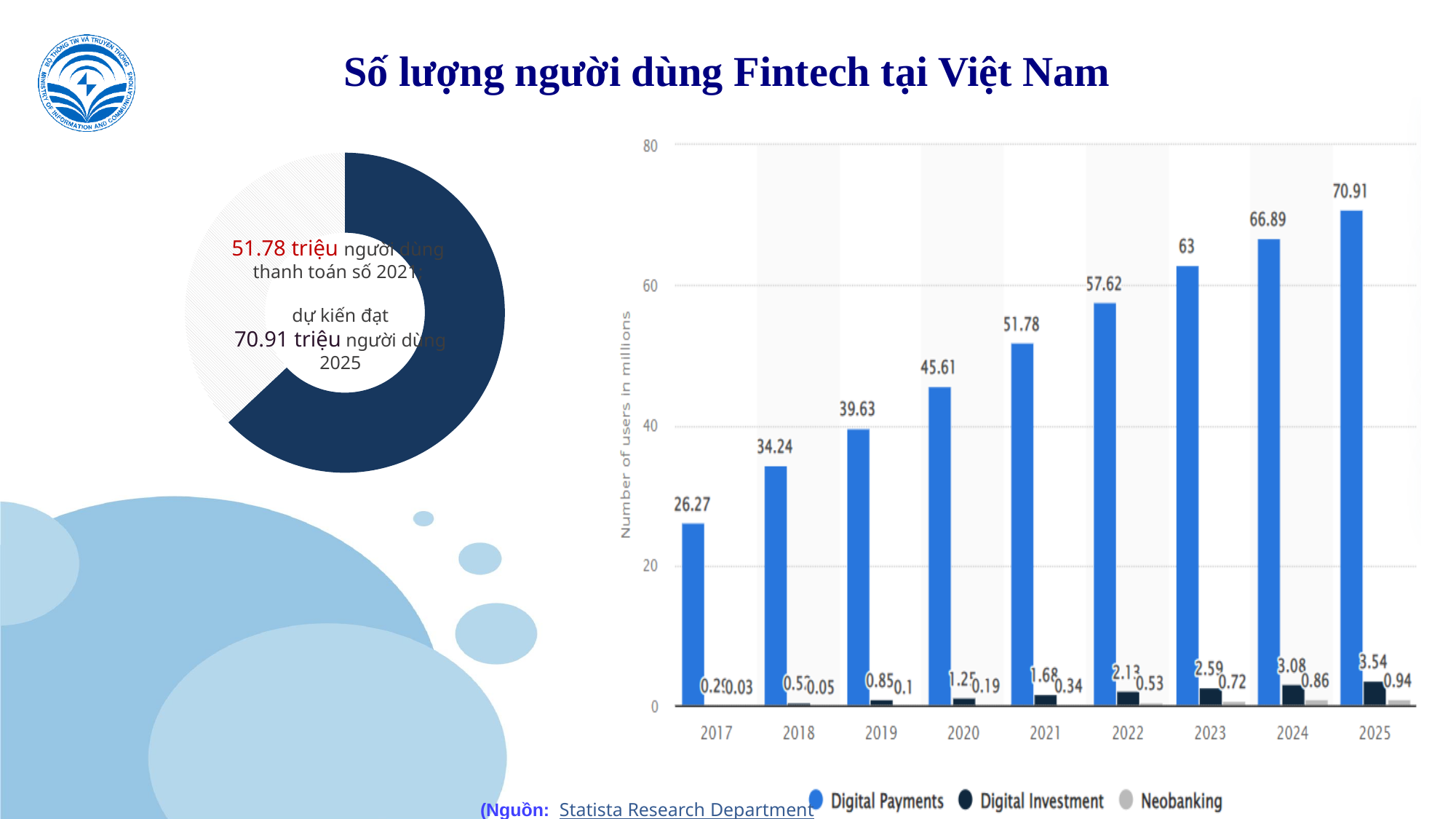
What kind of chart is shown on the left side of the slide? Donut (pie) chart In the bar chart on the right, what is the value for Digital Investment in 2024? 3.08 In the bar chart on the right, is the value for Digital Payments in 2019 greater or less than 40? less In the bar chart on the right, what is the difference between the Digital Payments values for 2025 and 2017? 44.64 In the bar chart on the right, what is the value for Neobanking in 2023? 0.72 How many series does the legend of the bar chart on the right list? 3 How many years are shown on the x axis of the bar chart on the right? 9 In the bar chart on the right, which year has the highest value for Digital Payments? 2025 In the bar chart on the right, what is the value for Digital Payments in 2025? 70.91 In the bar chart on the right, what is the value for Digital Payments in 2021? 51.78 In the bar chart on the right, which is larger in 2022: Digital Investment or Neobanking? Digital Investment In the bar chart on the right, which year has the lowest value for Digital Payments? 2017